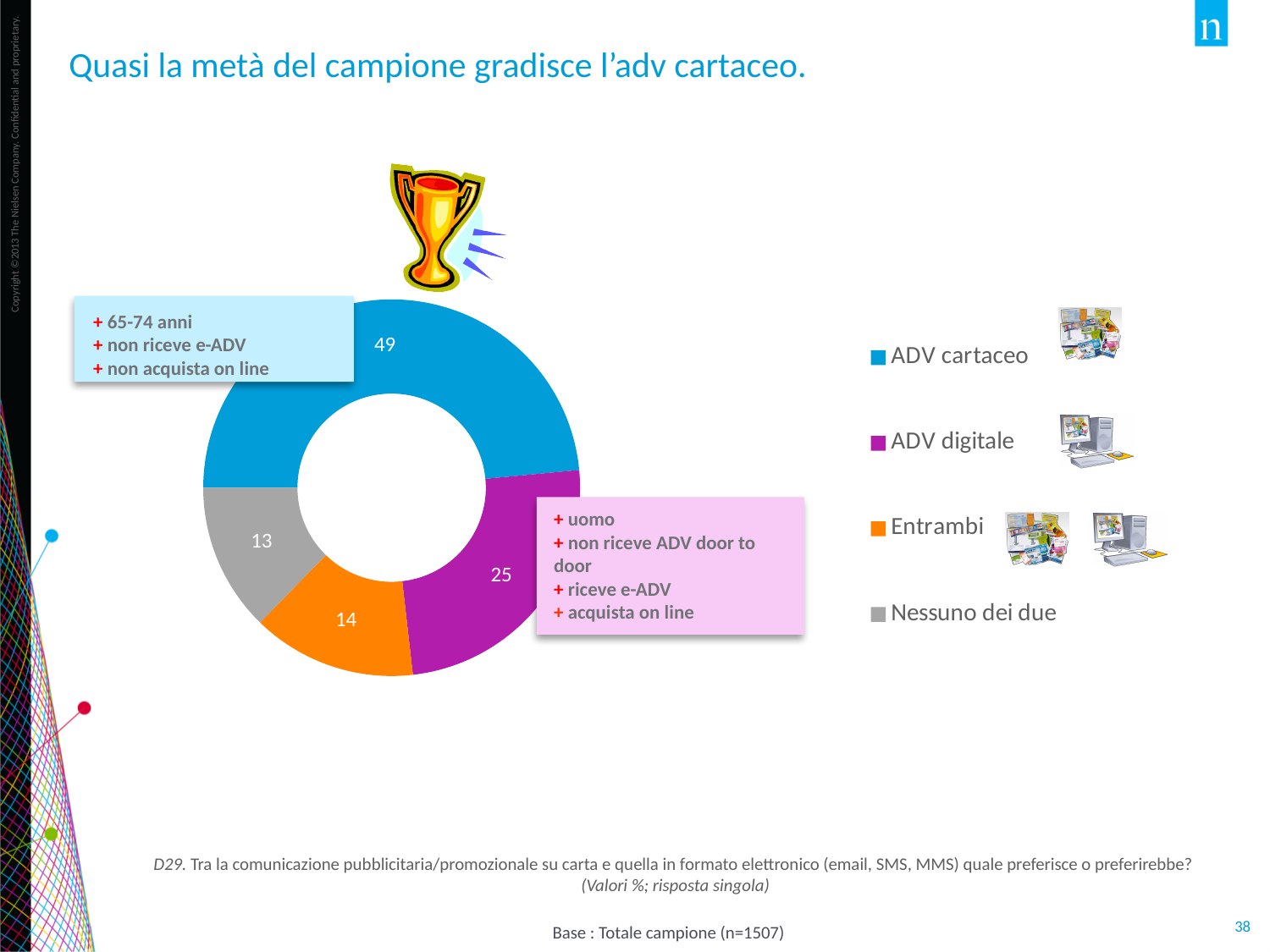
What is the value for ADV cartaceo? 49 Which is larger, the value for ADV digitale or the value for Entrambi? ADV digitale What is the difference between the values for ADV cartaceo and ADV digitale? 24 What kind of chart is shown on the slide? Doughnut (pie) chart Which category has the highest value? ADV cartaceo What is the value for ADV digitale? 25 Which colour represents ADV digitale in the chart? Purple What is the difference between the values for Entrambi and Nessuno dei due? 1 What is the value for Nessuno dei due? 13 What is the sample base (n) stated on the slide? n=1507 How many categories does the chart show? 4 What is the value for Entrambi? 14